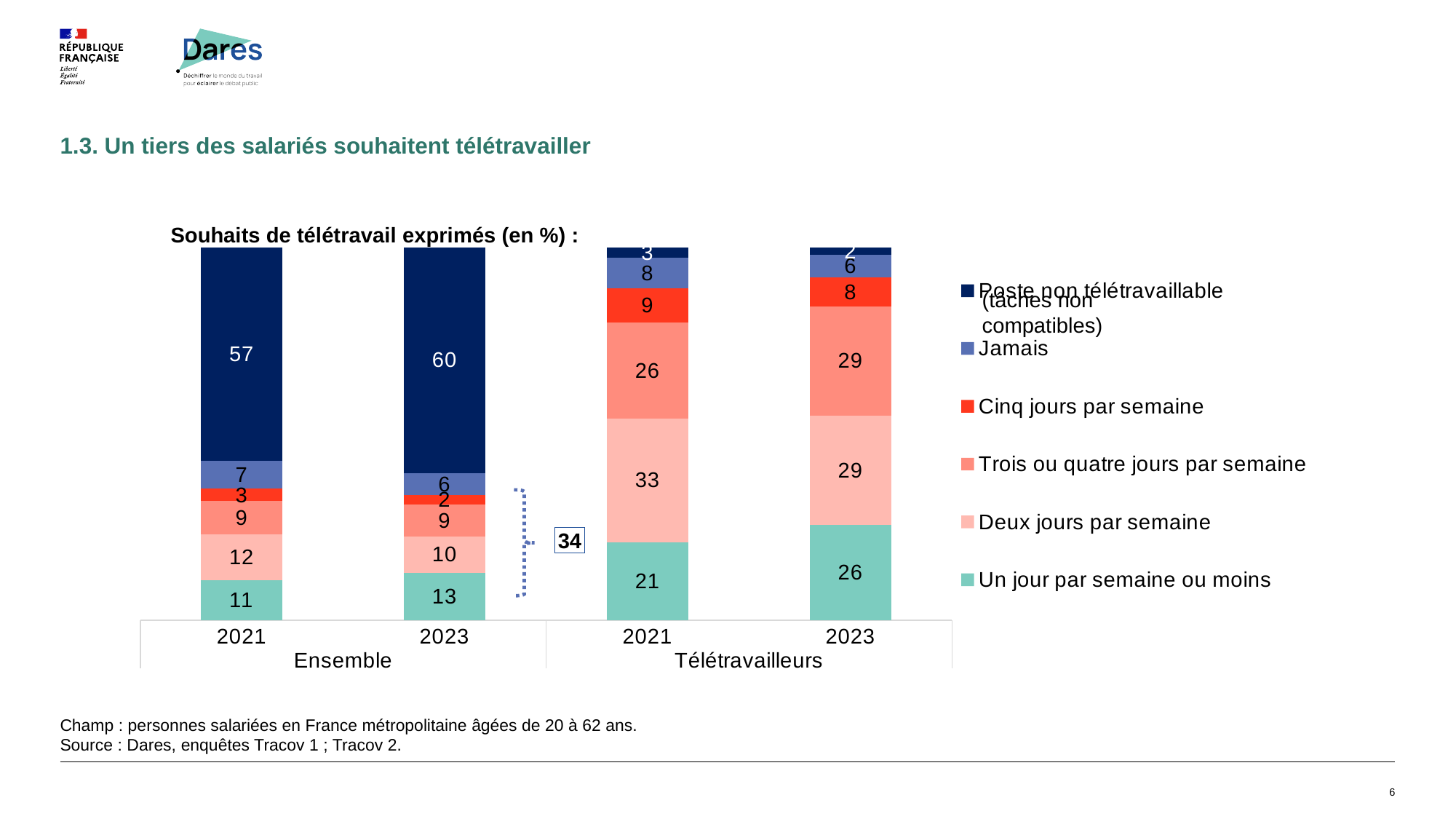
What is the value for 'Cinq jours par semaine' for Ensemble in 2021? 3 What is the difference between the 'Trois ou quatre jours par semaine' values for Télétravailleurs in 2023 and 2021? 3 How many bars are plotted in the chart? 4 Which bar has the lowest value for 'Un jour par semaine ou moins'? Ensemble 2021 Which bar has the highest value for 'Poste non télétravaillable (tâches non compatibles)'? Ensemble 2023 What is the value for 'Deux jours par semaine' for Télétravailleurs in 2021? 33 How many series does the legend list? 6 What is the title of the chart? Souhaits de télétravail exprimés (en %) : Which is larger: 'Jamais' for Télétravailleurs in 2021 or 'Jamais' for Télétravailleurs in 2023? Télétravailleurs 2021 What kind of chart is shown on the slide? Stacked bar chart What is the value for 'Un jour par semaine ou moins' for Télétravailleurs in 2023? 26 What is the value for 'Poste non télétravaillable (tâches non compatibles)' for Ensemble in 2023? 60